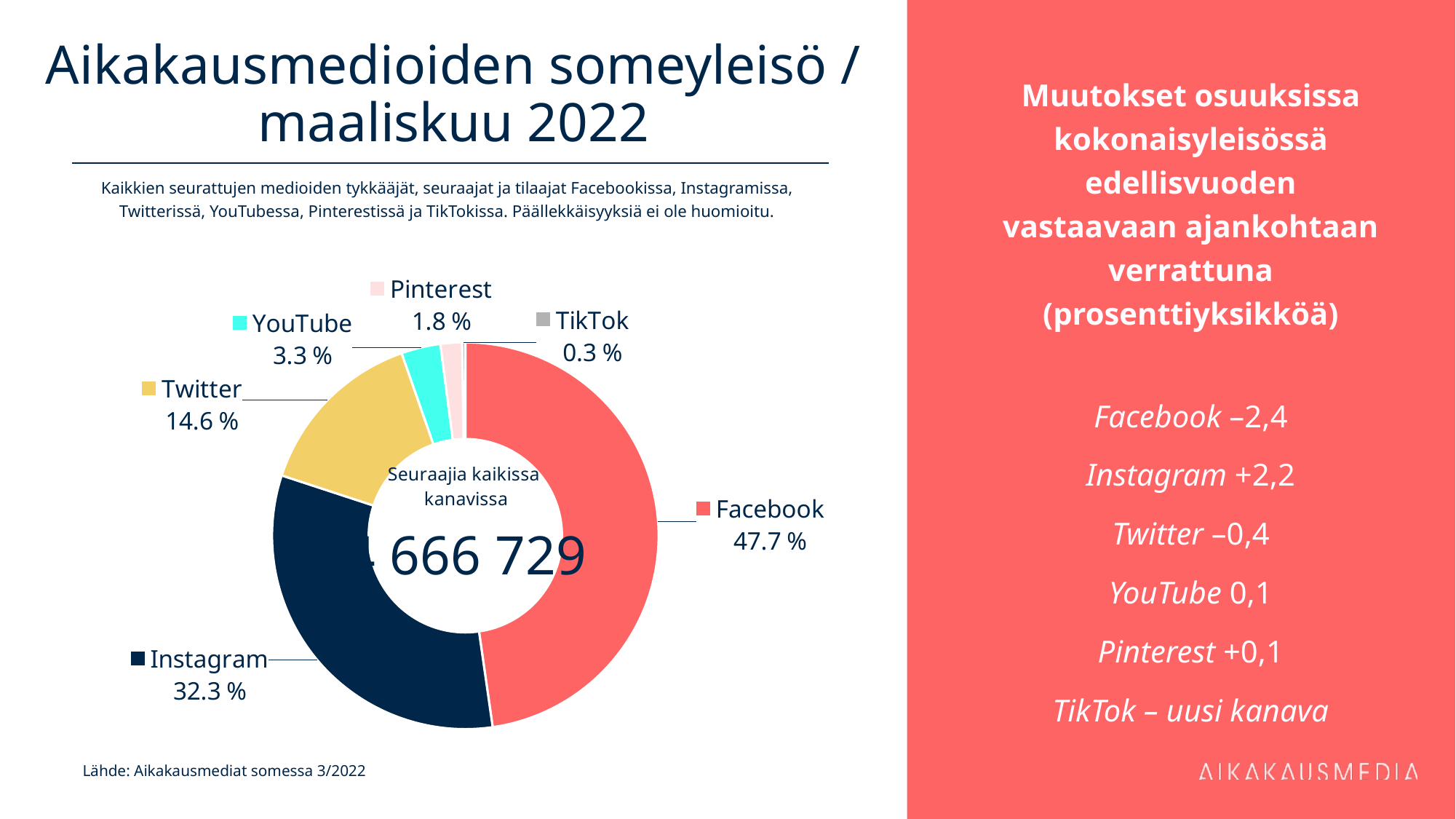
Which channel has the largest slice in the chart? Facebook What colour is the Twitter slice in the chart? Yellow What share of the doughnut chart does Instagram hold? 32.3 % Which channel has the smallest slice in the chart? TikTok Which has a larger share, YouTube or Pinterest? YouTube What is the value shown for Twitter in the chart? 14.6 % What is the value shown for TikTok in the chart? 0.3 % How many channels are shown as slices in the chart? 6 What share of the doughnut chart does Facebook hold? 47.7 % What is the difference in percentage points between Twitter's and YouTube's shares? 11.3 What is the difference in percentage points between Facebook's and Instagram's shares? 15.4 What type of chart is shown on the slide? Doughnut (pie) chart